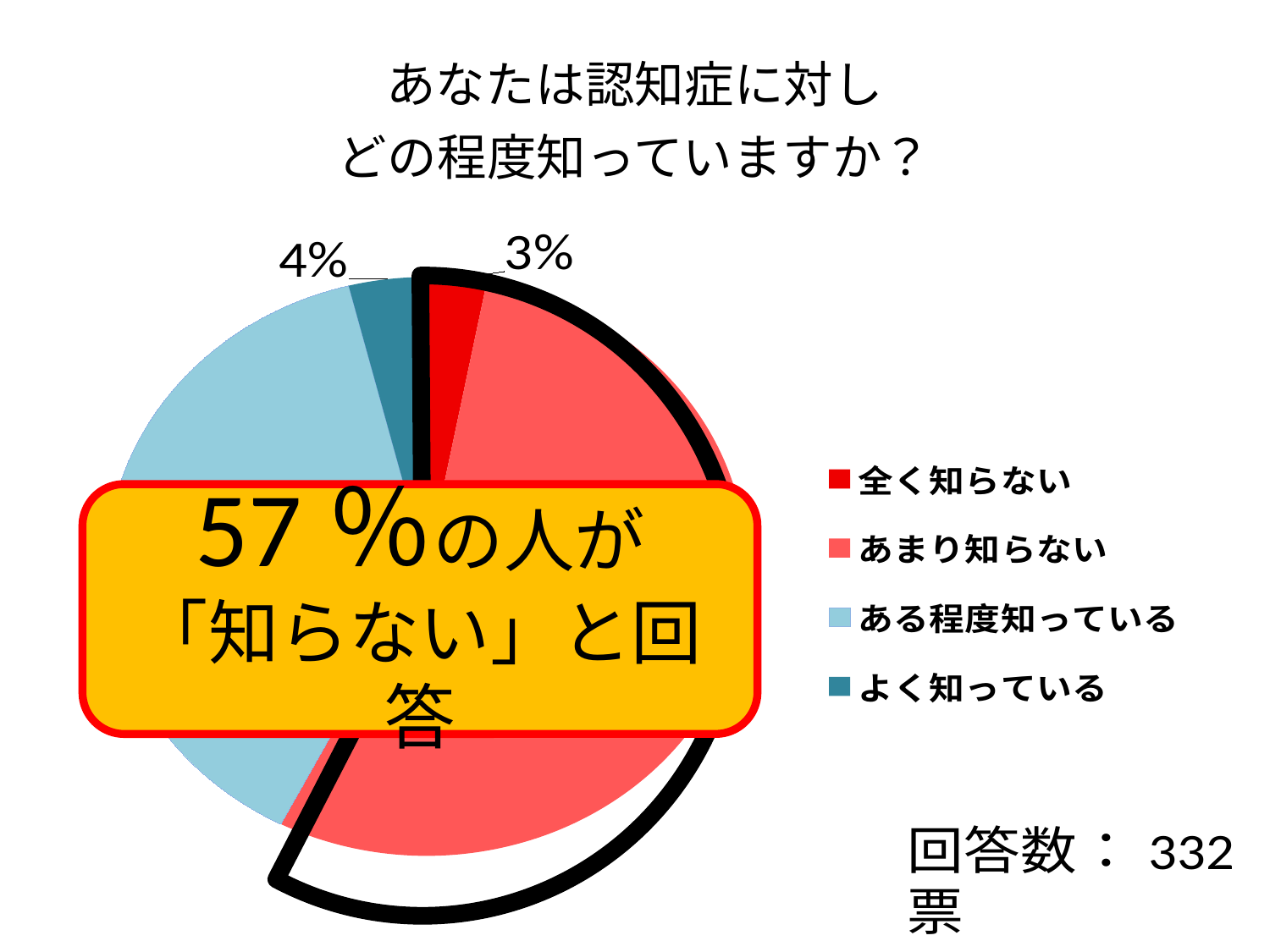
Which category has the smallest slice of the pie? 全く知らない Which category has the largest slice of the pie? あまり知らない What kind of chart is shown on the slide? pie chart Which is larger, the slice for よく知っている or the slice for 全く知らない? よく知っている What is the difference between the よく知っている slice and the 全く知らない slice? 1% What percentage of the pie is labelled for よく知っている? 4% What percentage of the pie is labelled for 全く知らない? 3% According to the callout on the chart, what percentage of people answered 「知らない」? 57％ How many categories does the legend of the pie chart list? 4 What is the title of the chart? あなたは認知症に対しどの程度知っていますか？ What share of the pie does the 全く知らない slice represent? 3%